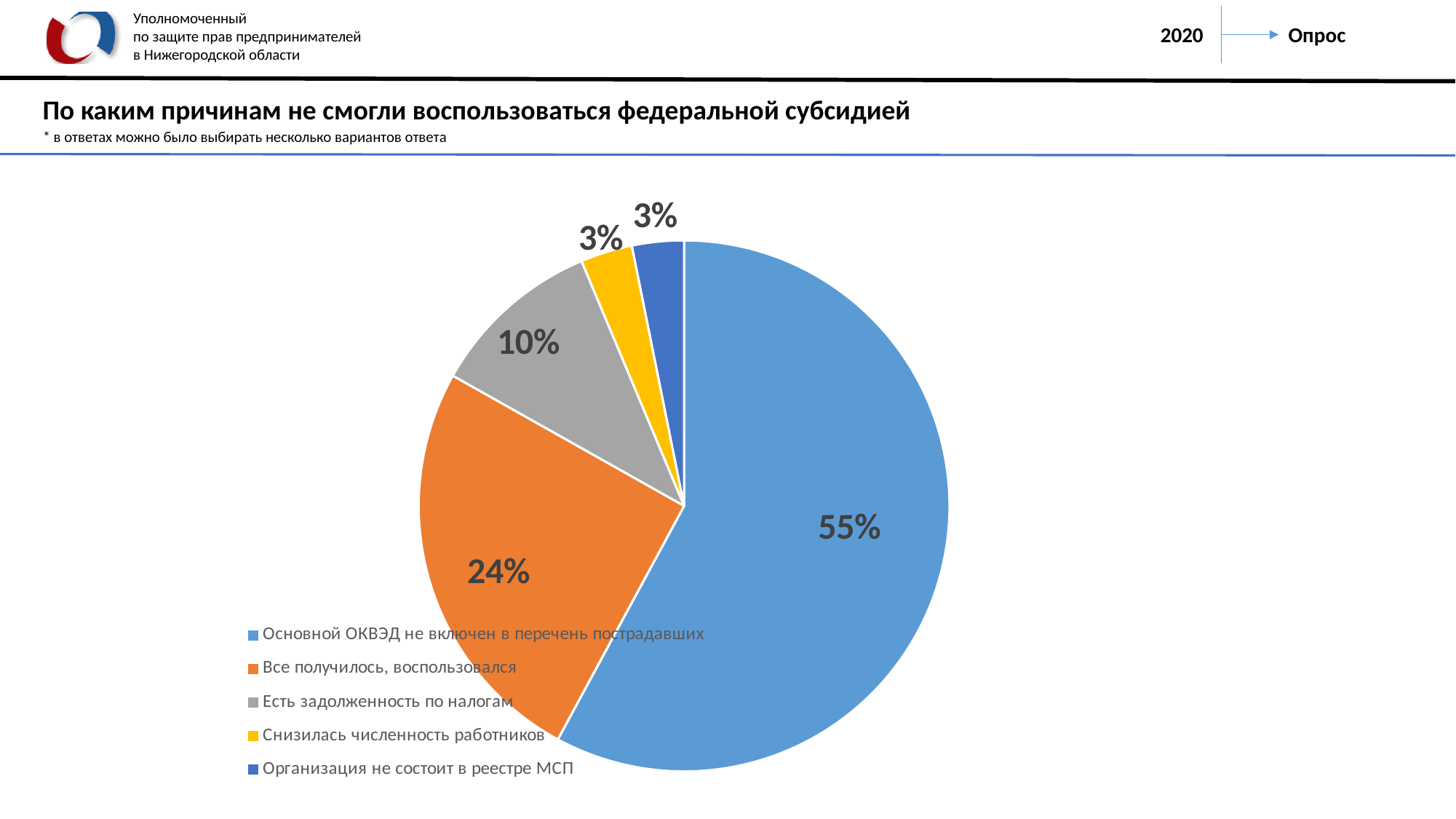
What is the value for "Есть задолженность по налогам"? 10% How many slices does the pie chart have? 5 What is the value for "Организация не состоит в реестре МСП"? 3% What is the value for "Все получилось, воспользовался"? 24% What is the difference between the values for "Основной ОКВЭД не включен в перечень пострадавших" and "Все получилось, воспользовался"? 31% Which is larger: the value for "Есть задолженность по налогам" or the value for "Снизилась численность работников"? Есть задолженность по налогам What kind of chart is shown on the slide? pie chart What is the value for "Снизилась численность работников"? 3% How many entries does the legend list? 5 What colour is the slice for "Снизилась численность работников"? yellow Which category has the largest slice of the pie? Основной ОКВЭД не включен в перечень пострадавших What share of the pie does "Основной ОКВЭД не включен в перечень пострадавших" take? 55%